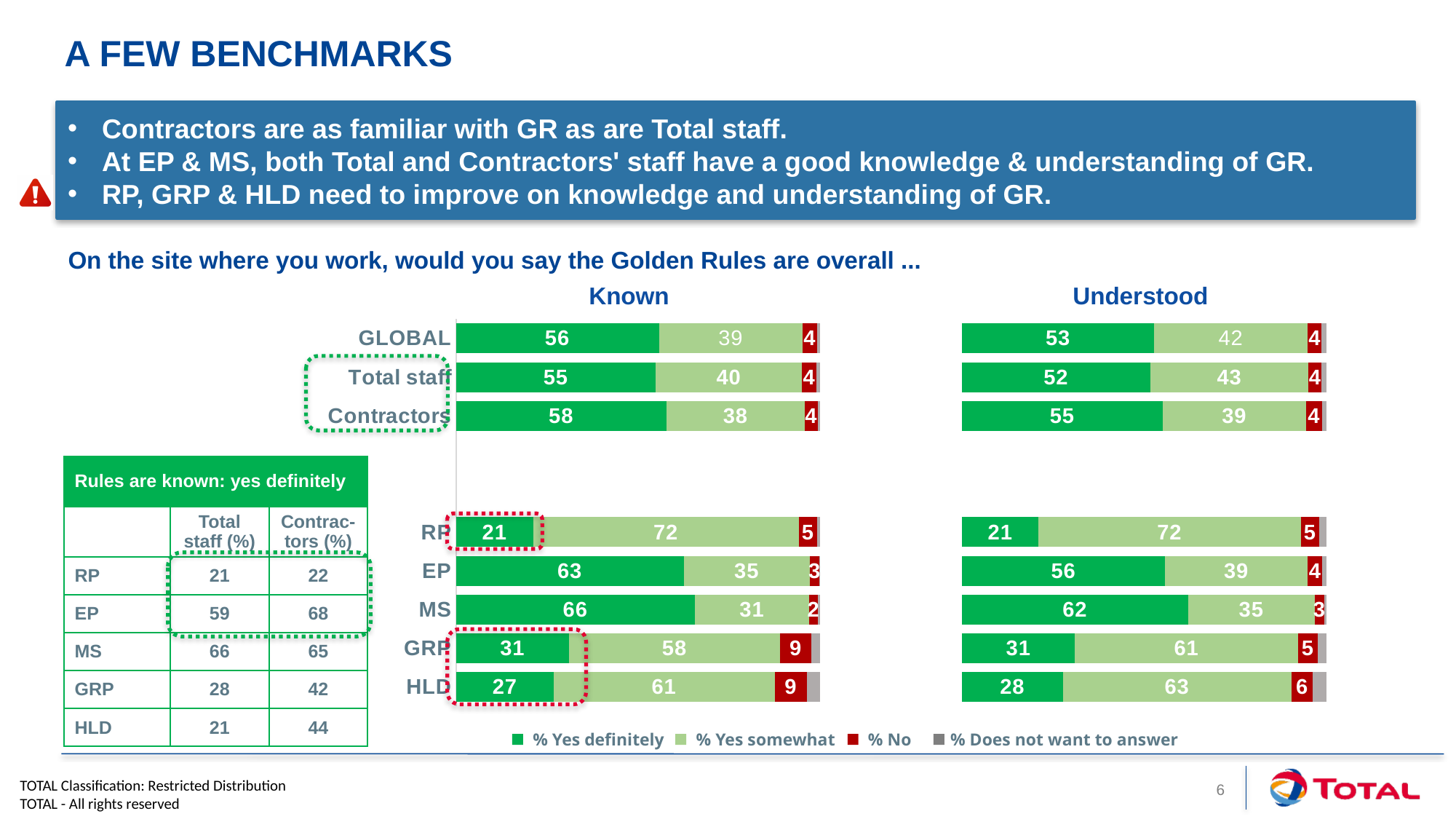
In the Known chart, which category has the lowest % Yes definitely value? RP In the Understood chart, what is the % No value for HLD? 6 In the Known chart, what is the % No value for GRP? 9 In the Understood chart, is the % Yes definitely value larger for EP or for HLD? EP In the Known chart, what is the difference between the % Yes definitely values for Contractors and Total staff? 3 How many series does the legend list for the charts? 4 In the Understood chart, what is the % Yes somewhat value for Total staff? 43 What kind of chart is the Understood chart? Stacked bar chart In the Understood chart, which category has the highest % Yes definitely value? MS How many categories are shown in the Known chart? 8 In the Known chart, what is the % Yes definitely value for GLOBAL? 56 What colour represents % No in the charts? Red